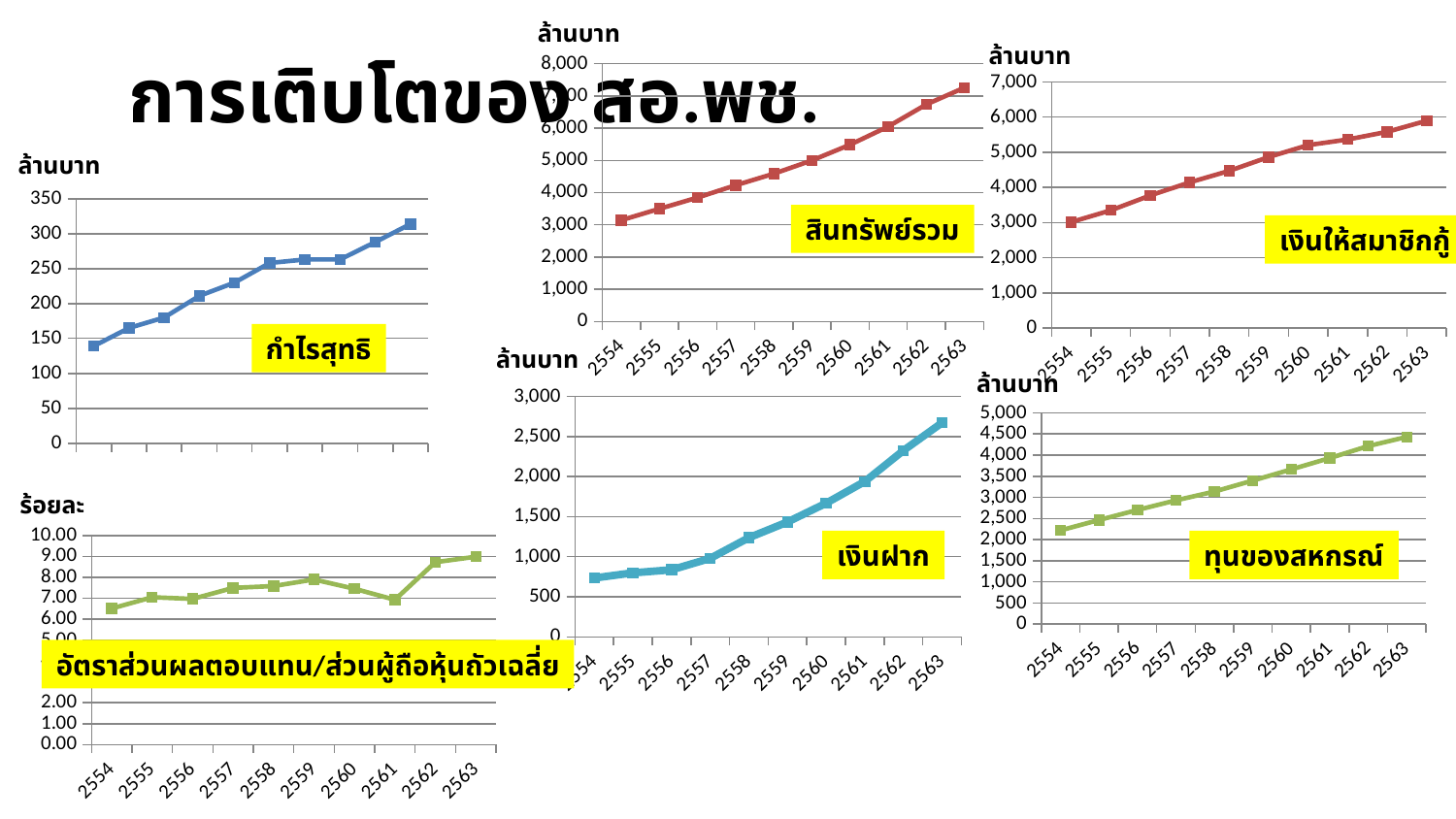
In the "กำไรสุทธิ" chart, is the last plotted value greater or less than 300? greater In the "สินทรัพย์รวม" chart, is the value for 2554 greater or less than 4,000? less In the "อัตราส่วนผลตอบแทน/ส่วนผู้ถือหุ้นถัวเฉลี่ย" chart, is the value for 2563 greater or less than 8.00? greater In the "เงินฝาก" chart, which year has the highest value? 2563 What kind of chart is the "เงินฝาก" chart? line chart How many charts are shown on the slide? 6 In the "สินทรัพย์รวม" chart, do the values rise or fall from 2554 to 2563? rise What unit is shown on the y axis of the "อัตราส่วนผลตอบแทน/ส่วนผู้ถือหุ้นถัวเฉลี่ย" chart? ร้อยละ In the "สินทรัพย์รวม" chart, how many years are plotted on the x axis? 10